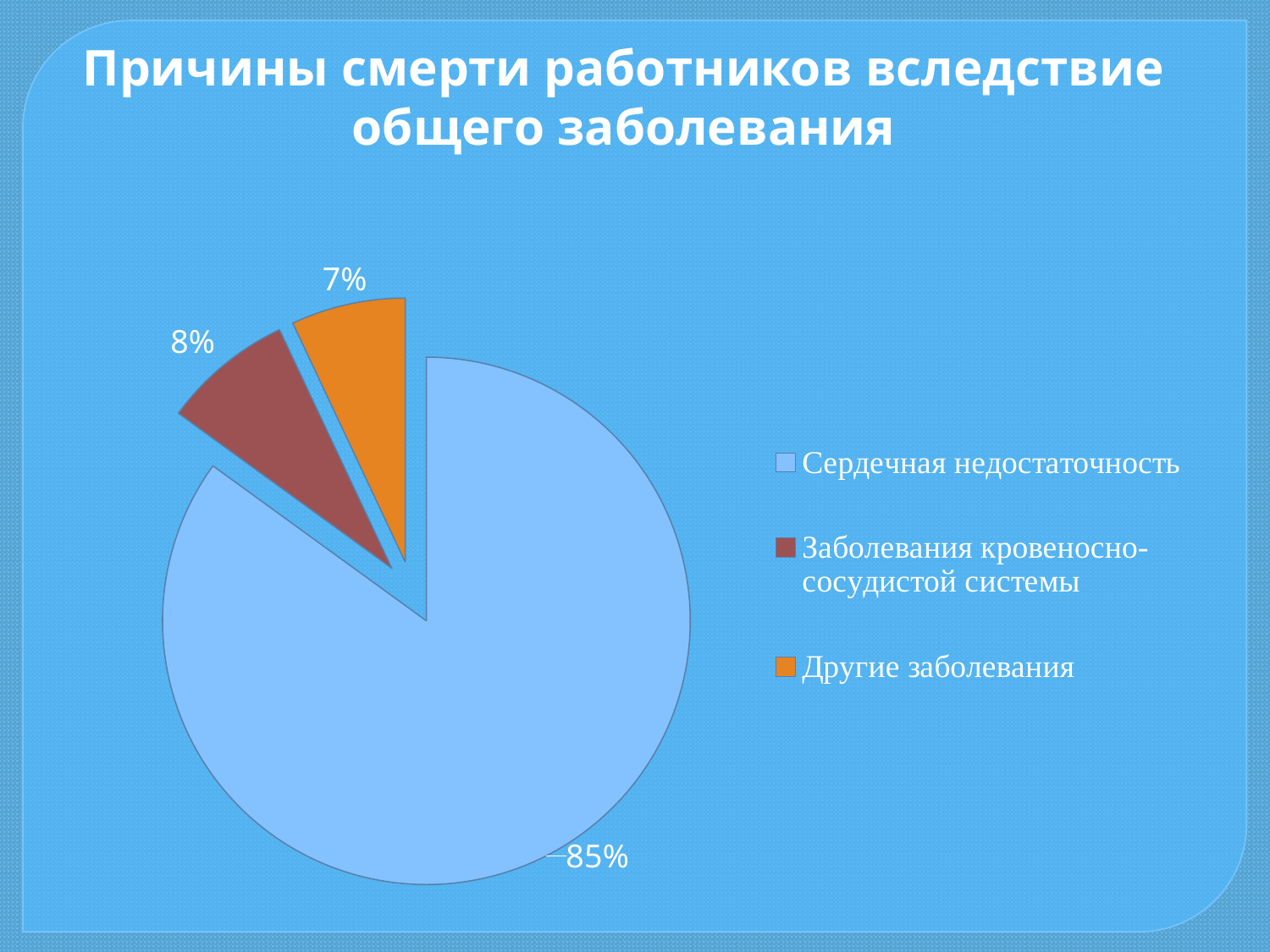
Which category has the smallest slice of the pie? Другие заболевания What is the title of the chart? Причины смерти работников вследствие общего заболевания What share of the pie does Другие заболевания have? 7% How many categories does the pie chart show? 3 Which colour represents Другие заболевания in the legend? orange Which category has the largest slice of the pie? Сердечная недостаточность What kind of chart is shown on the slide? pie chart Which is larger: the share for Сердечная недостаточность or the share for Другие заболевания? Сердечная недостаточность What share of the pie does Сердечная недостаточность have? 85% What share of the pie does Заболевания кровеносно-сосудистой системы have? 8% What is the difference between the share for Сердечная недостаточность and the share for Заболевания кровеносно-сосудистой системы? 77% What is the difference between the share for Заболевания кровеносно-сосудистой системы and the share for Другие заболевания? 1%